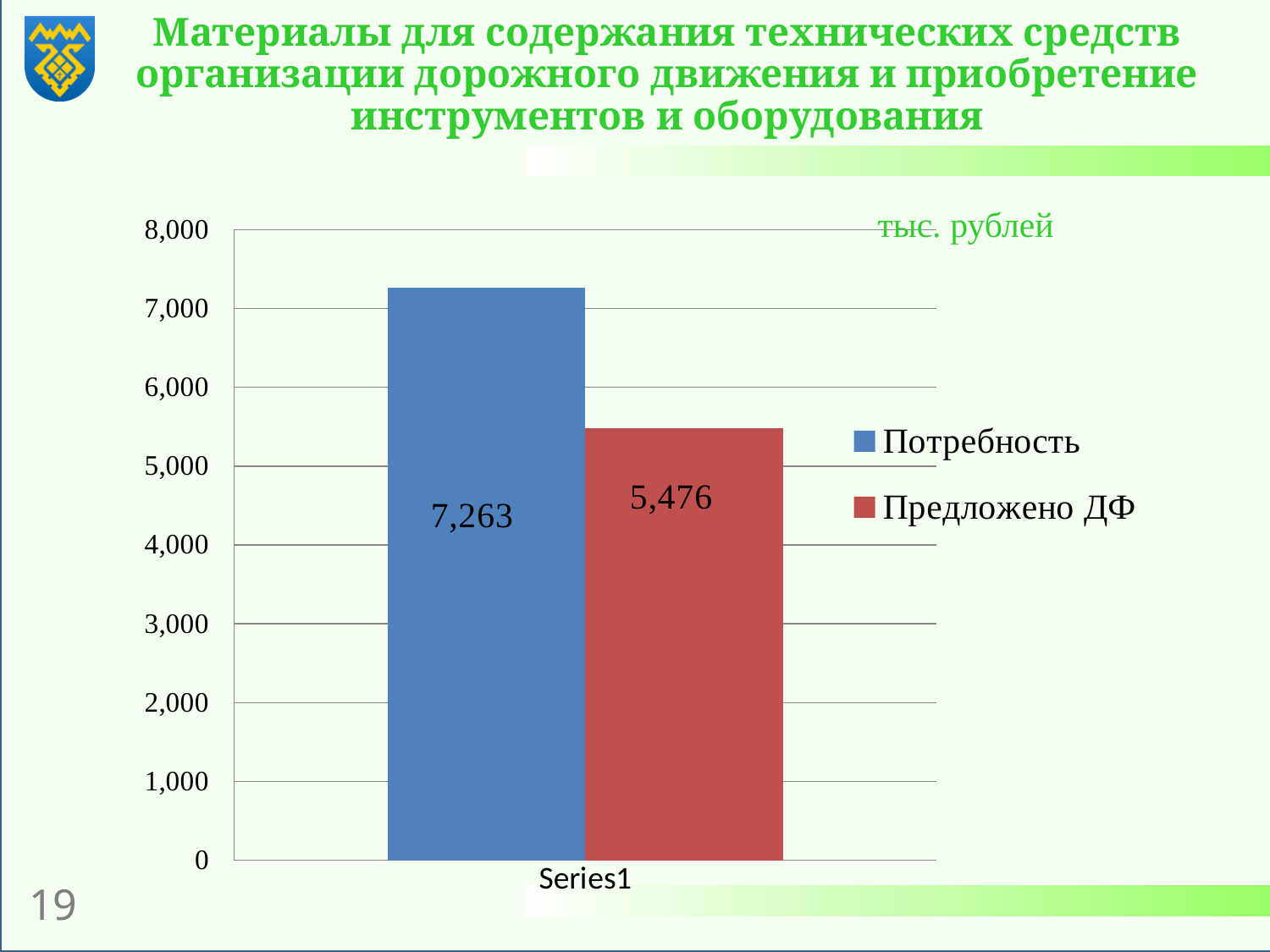
What is the category label shown on the x axis? Series1 Is the value for Предложено ДФ greater or less than 6,000? less Which series has the lowest value? Предложено ДФ What is the maximum value shown on the y axis? 8,000 What is the difference between the Потребность value and the Предложено ДФ value? 1,787 What unit is indicated above the chart? тыс. рублей What kind of chart is shown on the slide? bar chart Which series has the higher value, Потребность or Предложено ДФ? Потребность What is the value for Предложено ДФ? 5,476 What is the value for Потребность? 7,263 How many series does the legend list? 2 Is the value for Потребность greater or less than 7,000? greater